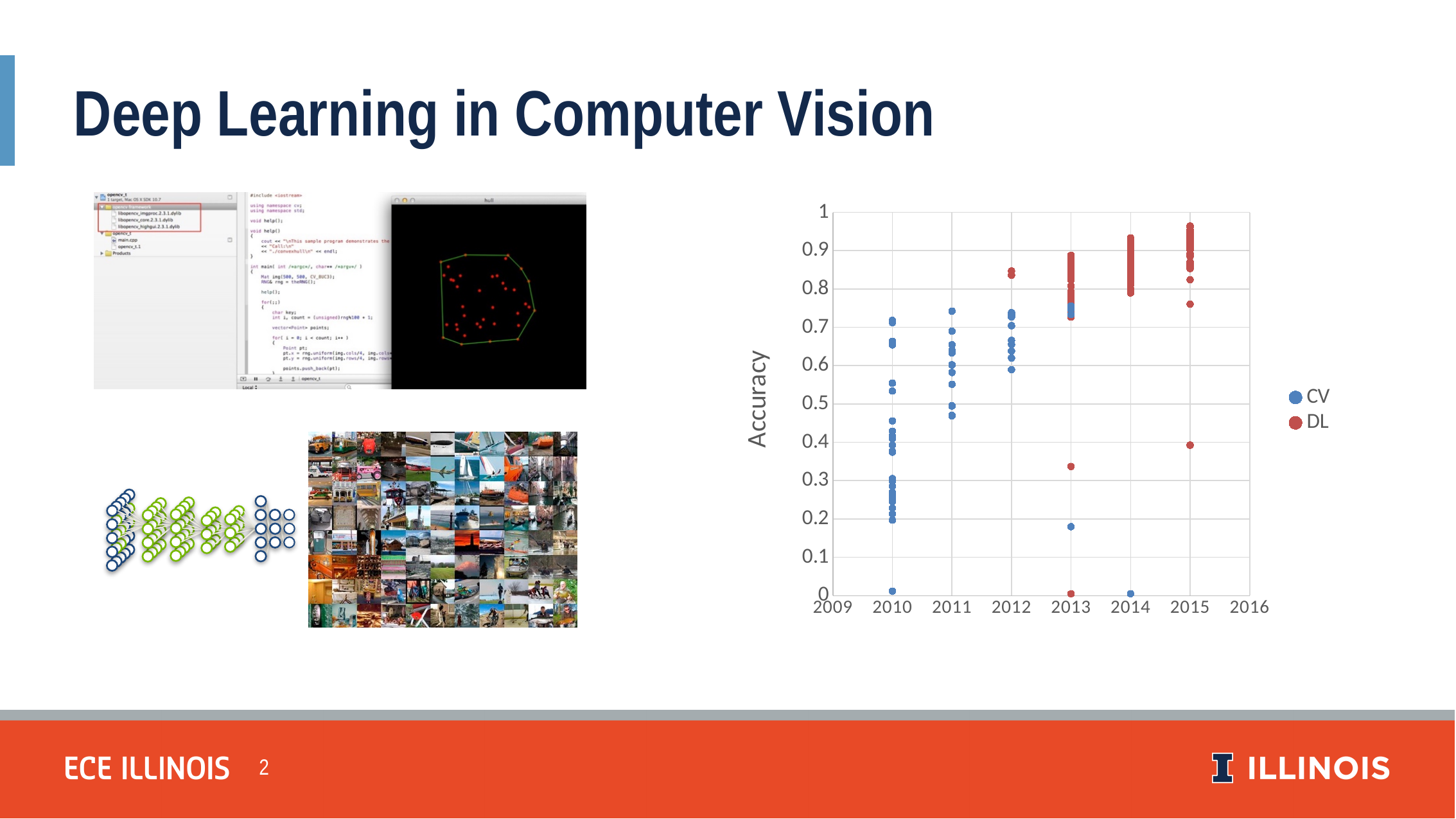
What are the two series named in the chart's legend? CV and DL What is the label on the chart's vertical axis? Accuracy Is the lowest DL accuracy value plotted for 2015 greater or less than 0.5? less What kind of chart is shown on the slide? scatter chart Are the DL accuracy values plotted for 2014 greater or less than 0.7? greater Is the highest DL accuracy value plotted for 2015 greater or less than 0.9? greater How many year labels are shown along the chart's x axis? 8 Do the highest accuracy values on the chart rise or fall from 2010 to 2015? rise In which year do DL points first appear on the chart? 2012 In 2013, which series reaches the higher maximum accuracy, CV or DL? DL How many series does the chart's legend list? 2